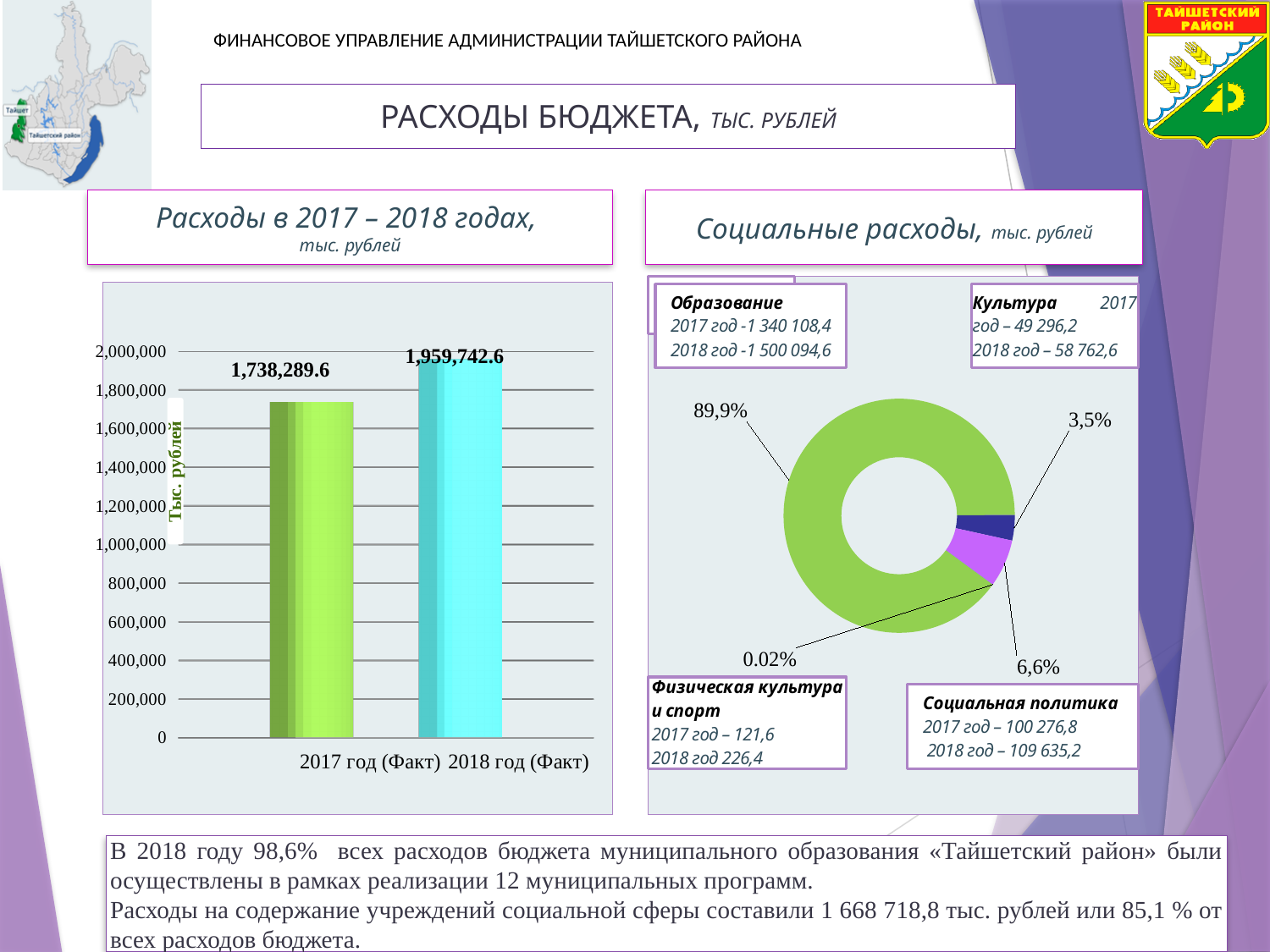
In the chart 'Расходы в 2017 – 2018 годах', do the values rise or fall from 2017 to 2018? rise In the chart 'Расходы в 2017 – 2018 годах', what is the difference between the 2018 and 2017 values? 221,453.0 In the chart 'Социальные расходы', how many slices are labelled with percentages? 4 What kind of chart is 'Социальные расходы'? doughnut chart In the chart 'Расходы в 2017 – 2018 годах', what is the value for 2018 год (Факт)? 1,959,742.6 In the chart 'Расходы в 2017 – 2018 годах', is the value for 2017 год (Факт) larger or smaller than the value for 2018 год (Факт)? smaller What kind of chart is 'Расходы в 2017 – 2018 годах'? bar chart In the chart 'Расходы в 2017 – 2018 годах', which year has the higher value? 2018 год (Факт) In the chart 'Расходы в 2017 – 2018 годах', how many bars are plotted? 2 In the chart 'Социальные расходы', what is the largest share shown? 89,9% In the chart 'Расходы в 2017 – 2018 годах', what is the label on the vertical axis? Тыс. рублей In the chart 'Расходы в 2017 – 2018 годах', what is the value for 2017 год (Факт)? 1,738,289.6